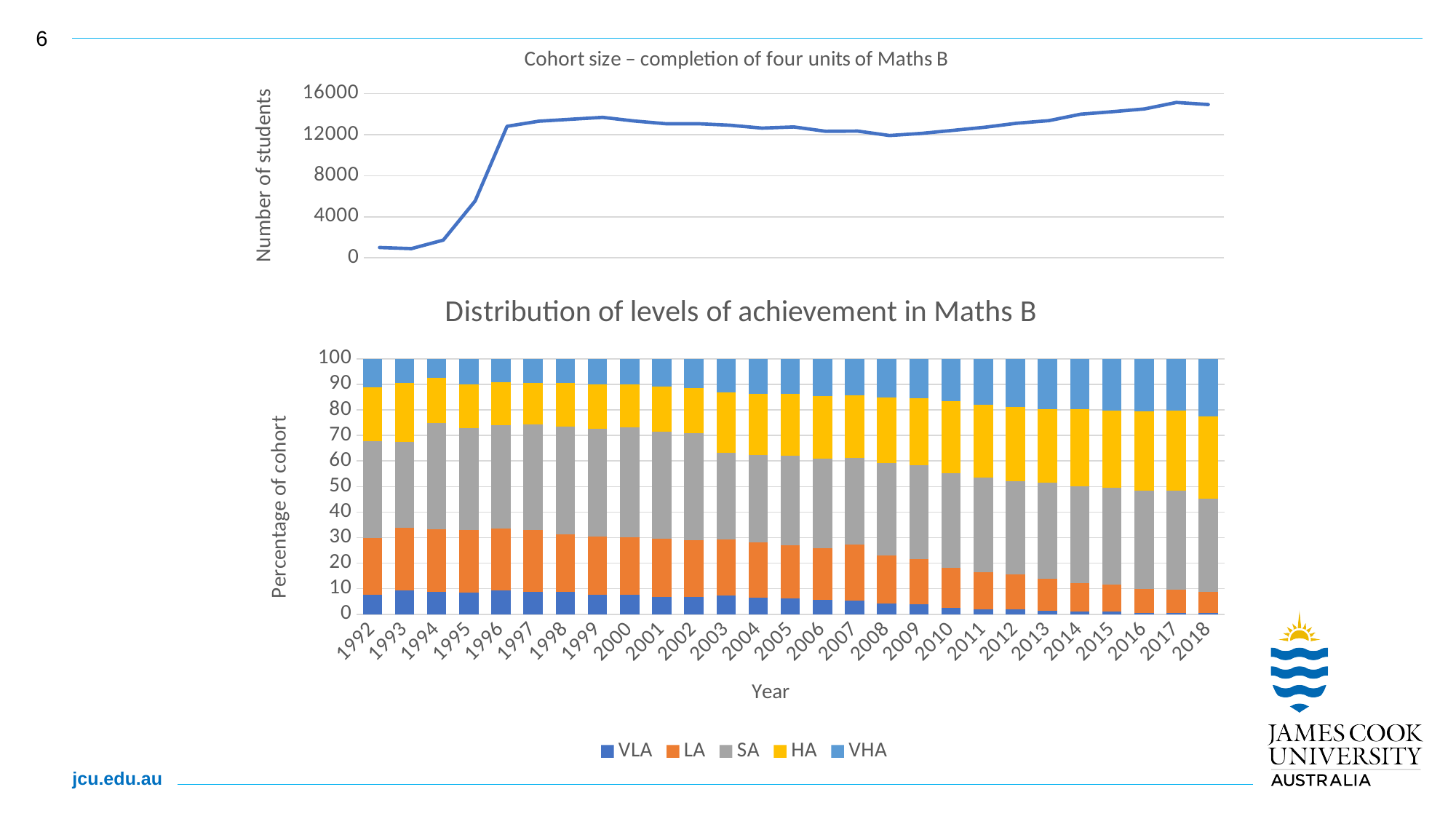
In the bottom chart 'Distribution of levels of achievement in Maths B', is the VLA value for 1992 greater or less than 10? less In the bottom chart 'Distribution of levels of achievement in Maths B', which series is shown in yellow? HA What kind of chart is the top chart titled 'Cohort size – completion of four units of Maths B'? line chart In the bottom chart 'Distribution of levels of achievement in Maths B', does the VHA share rise or fall from 1992 to 2018? rise How many years are shown on the x axis of the bottom chart 'Distribution of levels of achievement in Maths B'? 27 In the bottom chart 'Distribution of levels of achievement in Maths B', is the SA share larger in 1994 or in 2018? 1994 In the bottom chart 'Distribution of levels of achievement in Maths B', is the VHA share larger in 1992 or in 2018? 2018 In the bottom chart 'Distribution of levels of achievement in Maths B', does the VLA share rise or fall from 1992 to 2018? fall In the top chart 'Cohort size – completion of four units of Maths B', does the number of students overall rise or fall from the left of the x axis to the right? rise In the top chart 'Cohort size – completion of four units of Maths B', what is the label on the vertical axis? Number of students What kind of chart is the bottom chart titled 'Distribution of levels of achievement in Maths B'? stacked bar chart How many series does the legend of the bottom chart 'Distribution of levels of achievement in Maths B' list? 5